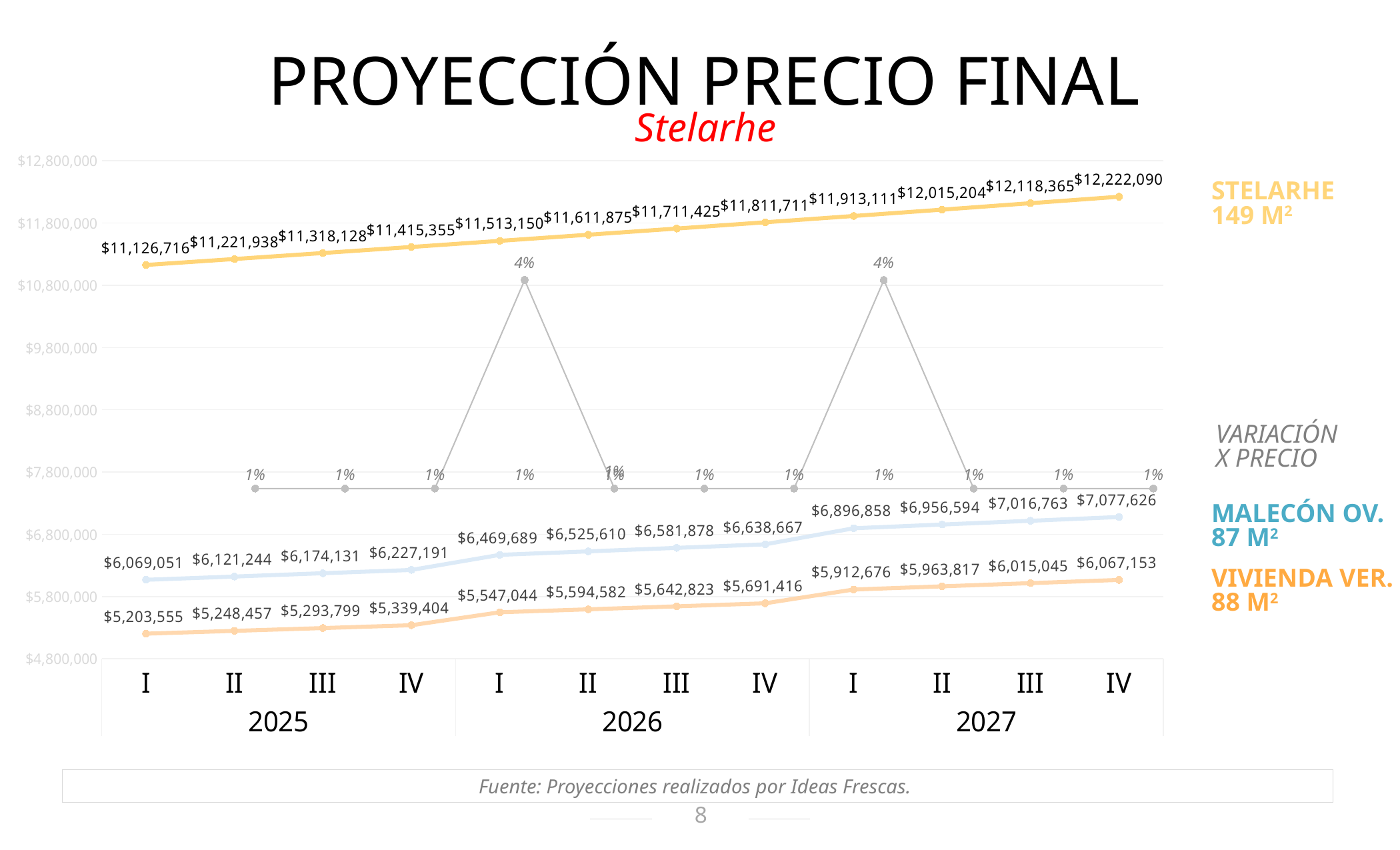
How many quarterly points are plotted along the x axis? 12 What is the difference between the MALECÓN OV. 87 M² price and the VIVIENDA VER. 88 M² price in quarter I of 2025? $865,496 What is the projected price for STELARHE 149 M² in quarter IV of 2027? $12,222,090 What is the projected price for STELARHE 149 M² in quarter I of 2025? $11,126,716 What kind of chart is shown on the slide? Line chart Which series has the highest projected price in quarter IV of 2027? STELARHE 149 M² What is the VARIACIÓN X PRECIO value shown for quarter I of 2026? 4% Does the STELARHE 149 M² price rise or fall from 2025 to 2027? Rise What is the projected price for VIVIENDA VER. 88 M² in quarter IV of 2027? $6,067,153 What is the projected price for MALECÓN OV. 87 M² in quarter I of 2026? $6,469,689 In quarter I of 2025, which is larger: the MALECÓN OV. 87 M² price or the VIVIENDA VER. 88 M² price? MALECÓN OV. 87 M² By how much does the STELARHE 149 M² price increase from quarter I of 2025 to quarter IV of 2027? $1,095,374